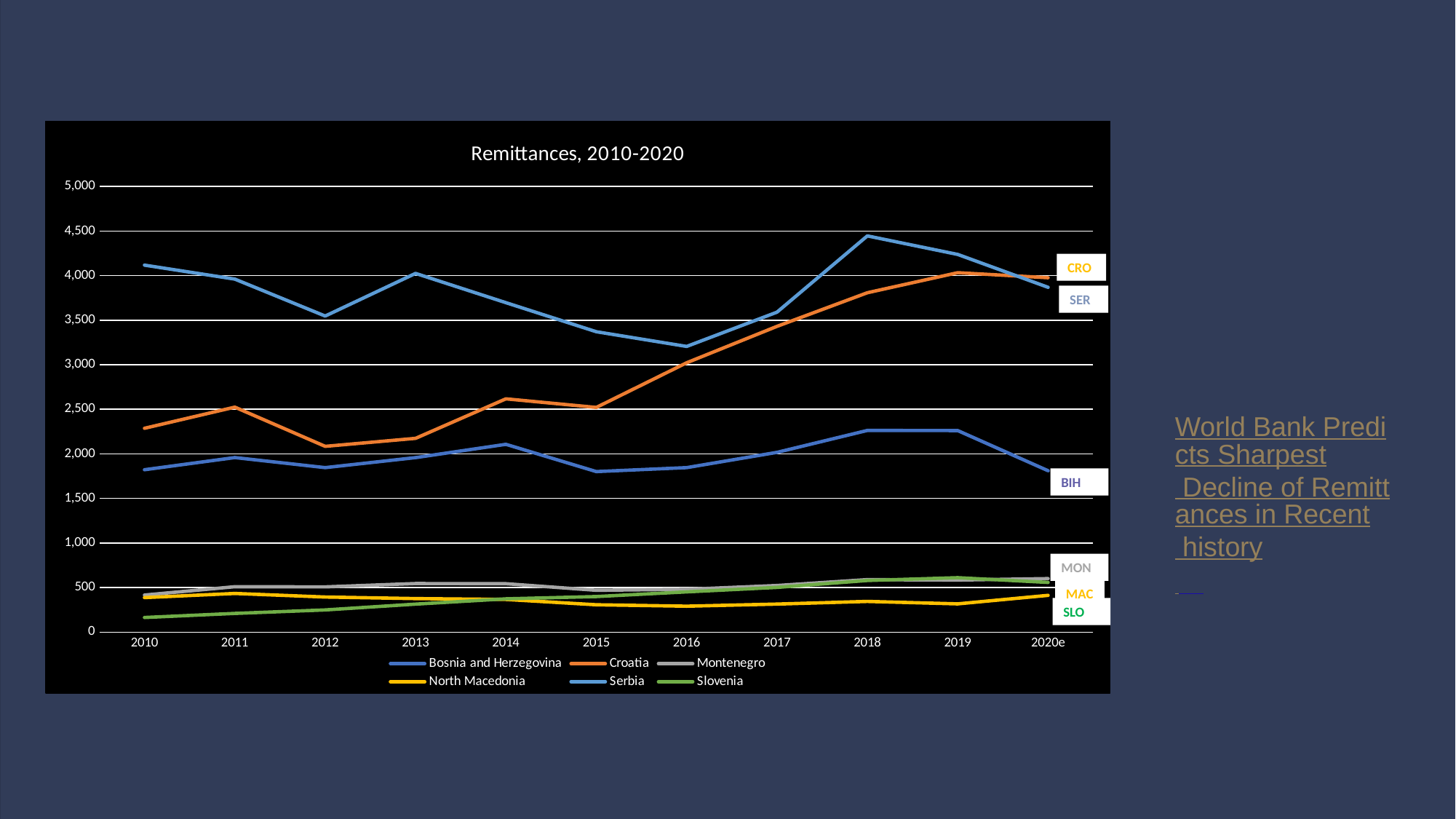
Which country had the lowest remittances in 2010? Slovenia Is the value for Croatia in 2010 greater or less than 2,500? less How many years are plotted along the x axis? 11 How many series does the legend list? 6 What is the title of the chart? Remittances, 2010-2020 Is the value for Bosnia and Herzegovina in 2015 greater or less than 2,000? less What kind of chart is shown on the slide? line chart Which country had the highest remittances in 2010? Serbia Is the value for Serbia in 2018 greater or less than 4,000? greater In which year does the Serbia line reach its highest point? 2018 Which series is drawn in orange? Croatia Does the Croatia line generally rise or fall from 2015 to 2019? rise